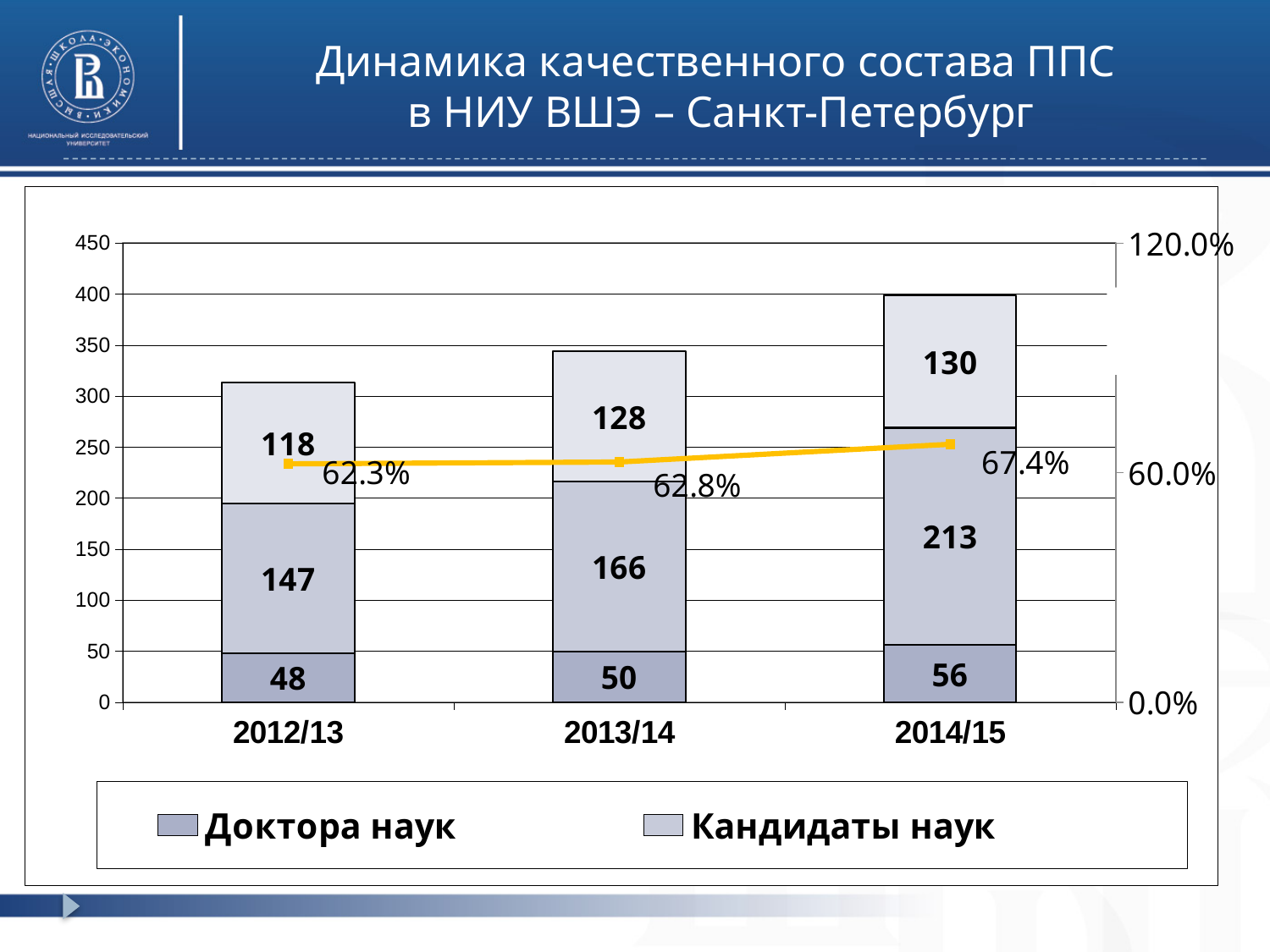
What is the value for Доктора наук in 2014/15? 56 What is the difference between the Кандидаты наук values for 2014/15 and 2013/14? 47 Do the percentage values on the line rise or fall from 2012/13 to 2014/15? rise In which year is the value for Доктора наук the lowest? 2012/13 In which year is the value for Кандидаты наук the highest? 2014/15 How many series does the legend list? 2 How many academic years are shown on the x axis? 3 Which year has the larger value for Доктора наук, 2012/13 or 2013/14? 2013/14 What percentage is shown on the line for 2012/13? 62.3% What kind of chart is this? combination stacked bar and line chart What is the value for Кандидаты наук in 2013/14? 166 What is the total of the stacked bar for 2014/15? 399